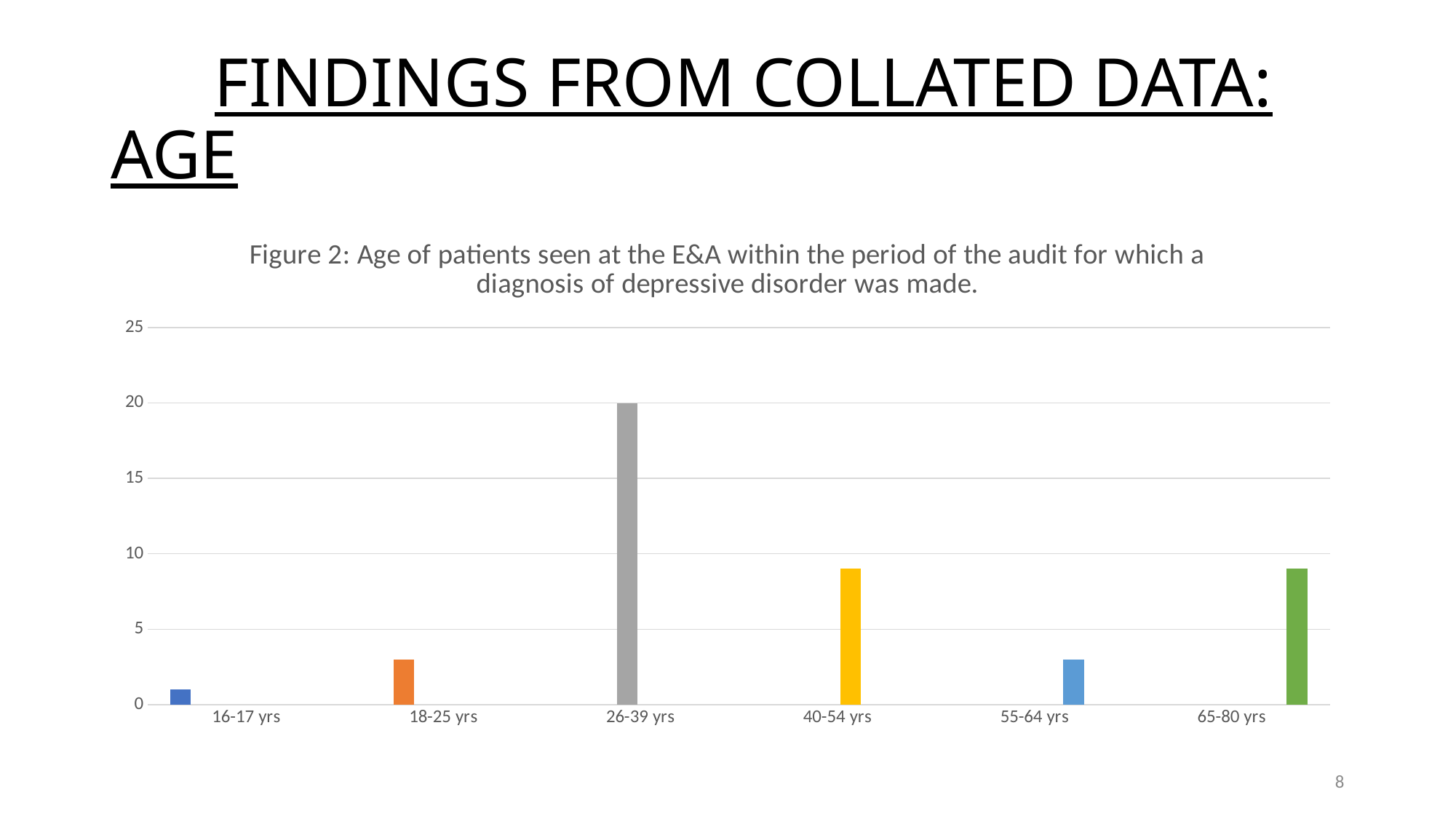
What is the figure number given in the chart title? Figure 2 Is the value for 18-25 yrs greater or less than 5? less How many age groups are shown on the x axis? 6 What kind of chart is shown on the slide? bar chart Which is larger, the value for 40-54 yrs or the value for 18-25 yrs? 40-54 yrs Is the value for 40-54 yrs greater or less than 10? less Is the value for 55-64 yrs greater or less than 5? less Which age group has the highest value? 26-39 yrs Which is larger, the value for 26-39 yrs or the value for 40-54 yrs? 26-39 yrs What is the value for the 26-39 yrs age group? 20 Which age group has the lowest value? 16-17 yrs